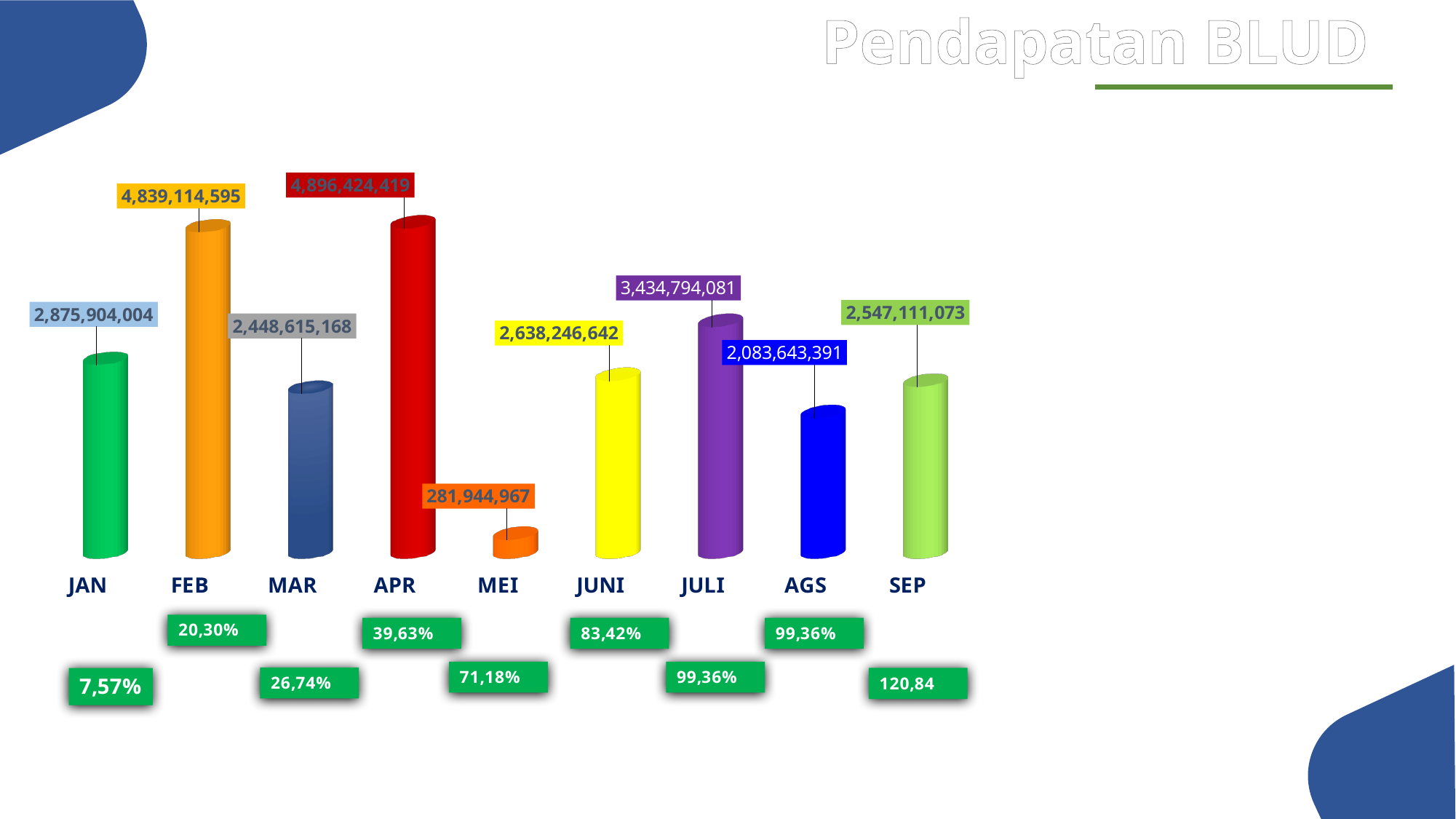
Which month has the highest Pendapatan BLUD value? APR Which is larger, the value for JUNI or the value for AGS? JUNI What kind of chart is shown on the slide? bar chart What is the difference between the JULI and AGS values? 1,351,150,690 Which month has the lowest Pendapatan BLUD value? MEI What is the Pendapatan BLUD value for JAN? 2,875,904,004 What is the difference between the FEB and MAR values? 2,390,499,427 How many months are shown in the chart? 9 Which is larger, the value for JAN or the value for SEP? JAN What is the Pendapatan BLUD value for JULI? 3,434,794,081 What percentage is shown below the APR bar? 39,63% What is the Pendapatan BLUD value for SEP? 2,547,111,073